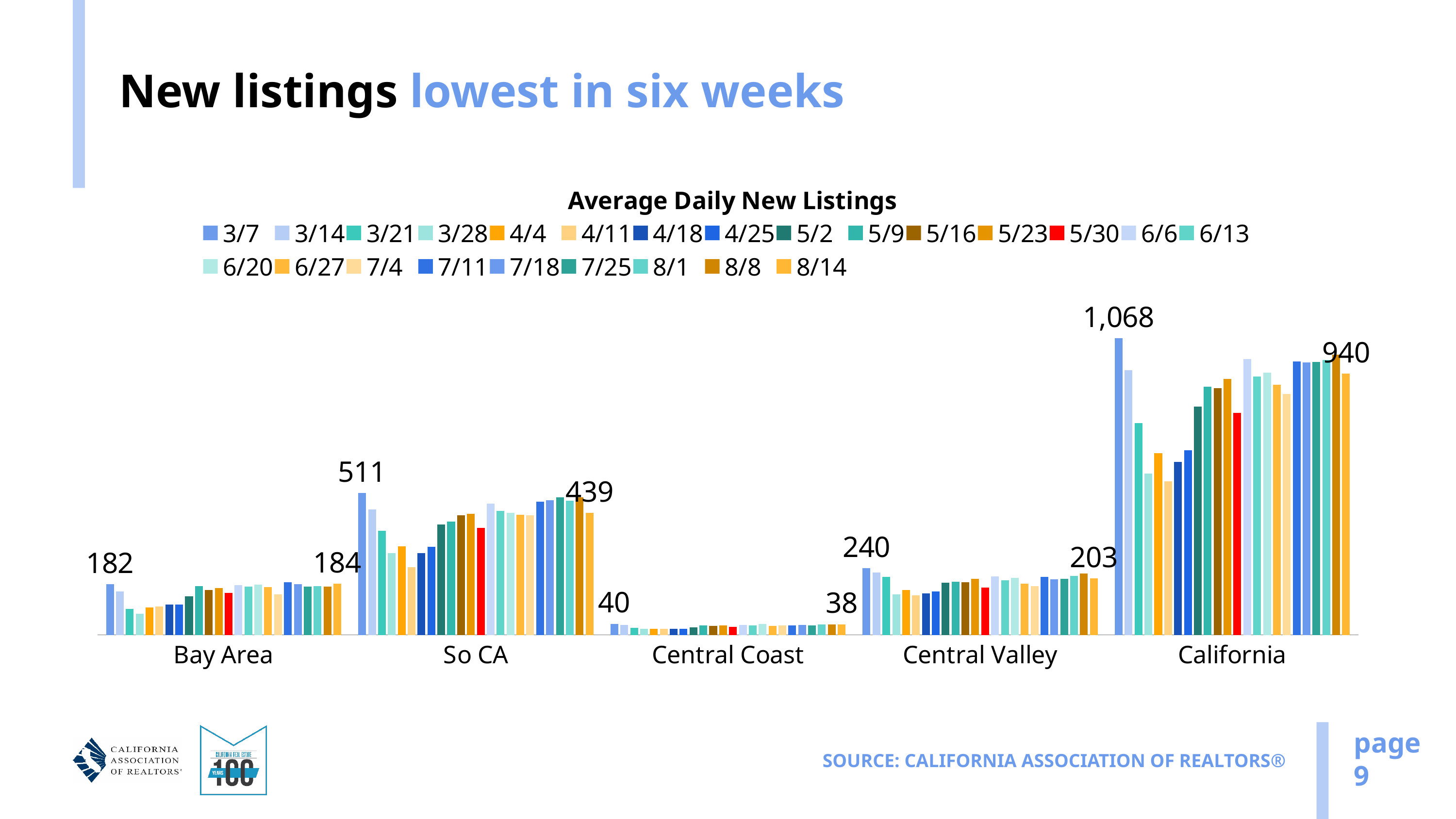
What is the average daily new listings value for California on 8/14? 940 What is the value for So CA on 3/7? 511 Which region has the lowest average daily new listings across the chart? Central Coast How many series does the chart's legend list? 24 Which is larger for the Bay Area: the 3/7 value or the 8/14 value? 8/14 (184) What is the value for Central Valley on 8/14? 203 What kind of chart is shown on the slide? Bar chart What is the title of the chart? Average Daily New Listings What is the difference between California's 3/7 value and its 8/14 value? 128 What is the average daily new listings value for California on 3/7? 1,068 What is the value for Central Coast on 3/7? 40 How many regions (categories) are shown on the x axis of the chart? 5